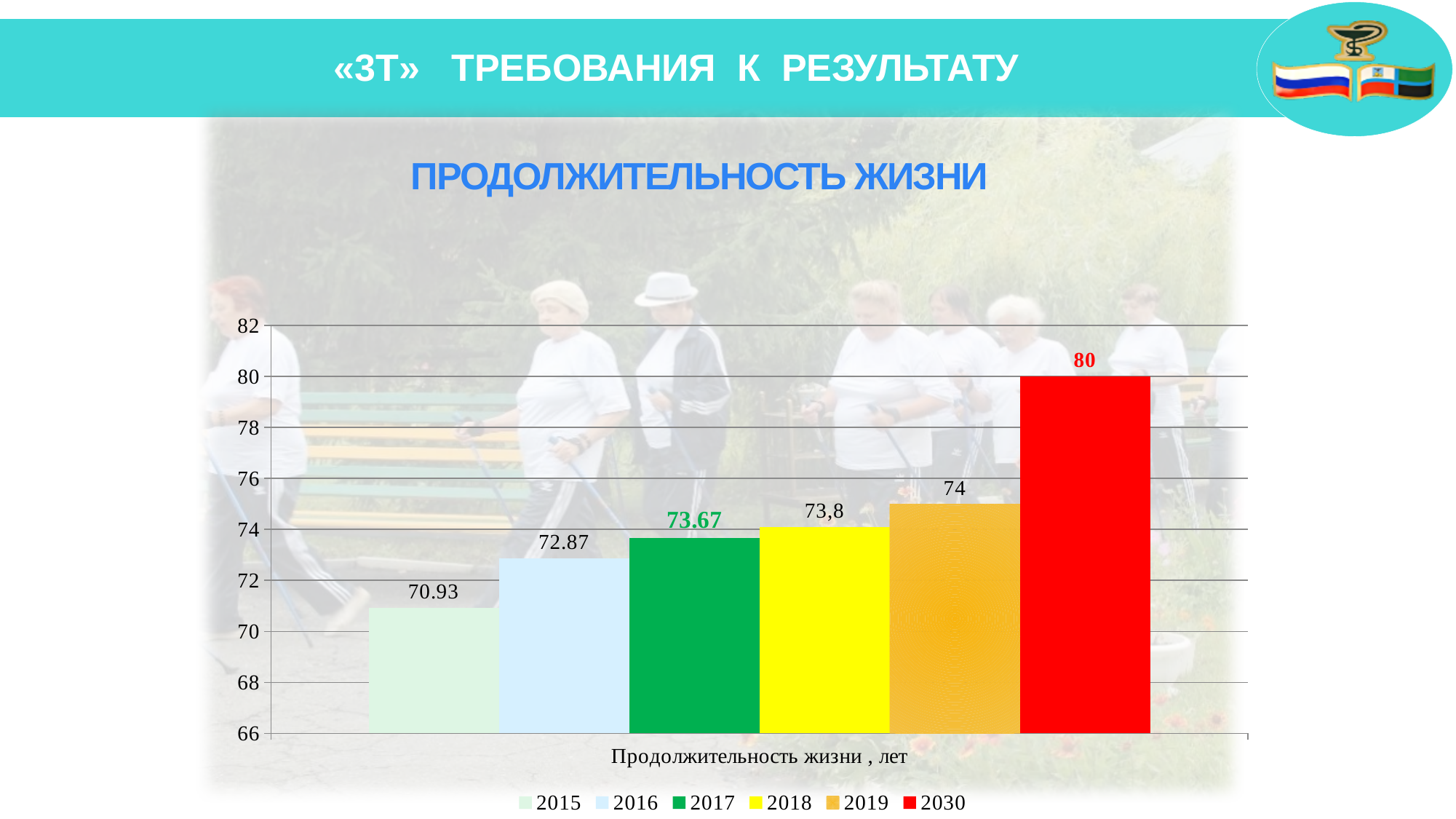
What is the life expectancy value shown for 2015? 70.93 Which is larger, the value for 2016 or the value for 2017? 2017 What is the value shown for 2018? 73,8 How many series does the legend list? 6 What is the label on the horizontal axis of the chart? Продолжительность жизни , лет What kind of chart is shown on the slide? Bar chart Which year has the highest value on the chart? 2030 Which year has the lowest value on the chart? 2015 What is the difference between the values for 2030 and 2019? 6 What is the value shown for 2016? 72.87 What is the value shown for 2030? 80 What is the value shown for 2017? 73.67